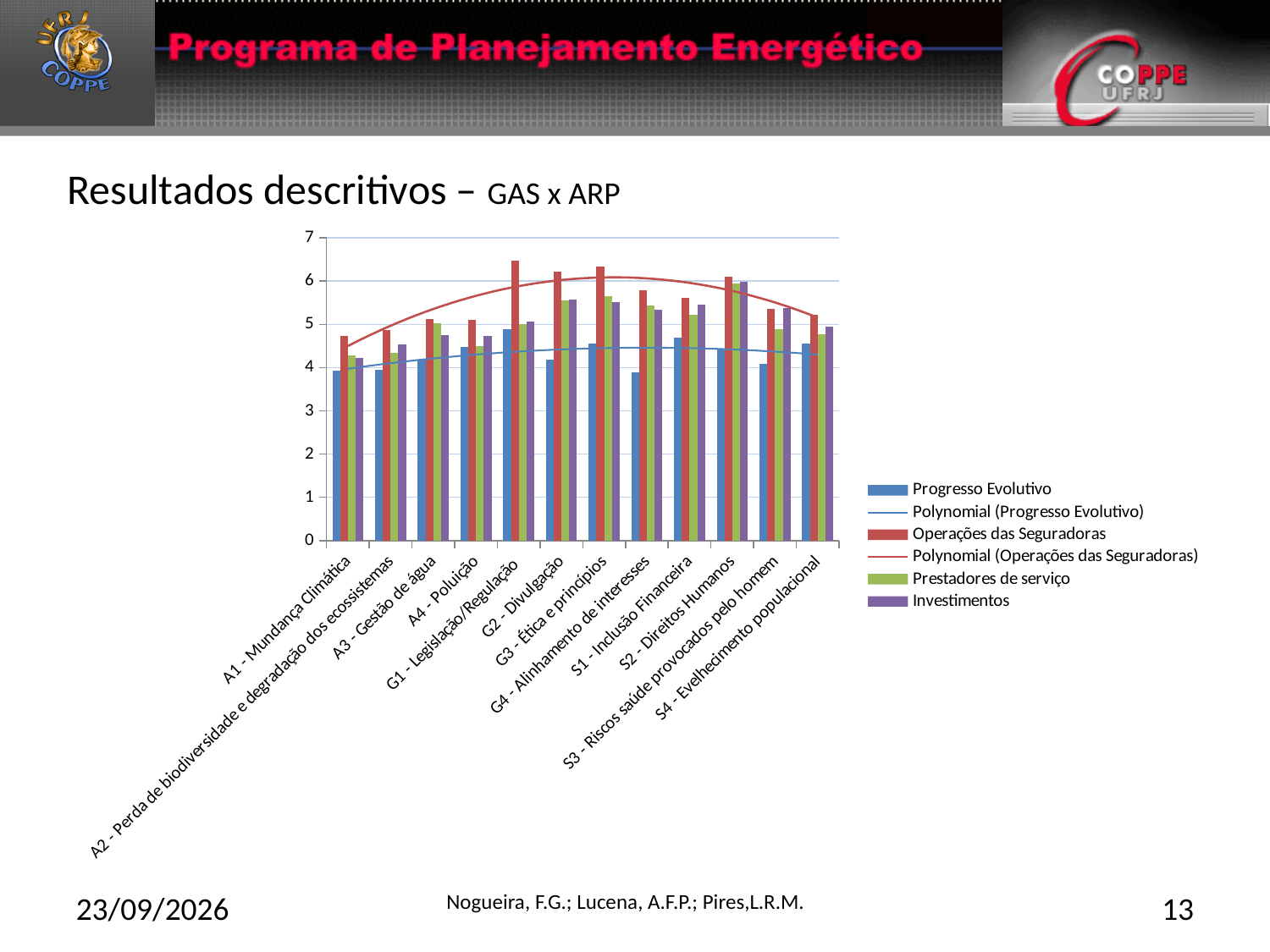
How many categories are shown along the x axis of the chart? 12 At S2 - Direitos Humanos, which is larger: Progresso Evolutivo or Investimentos? Investimentos Is the value for Operações das Seguradoras at A1 - Mundança Climática greater or less than 5? less What kind of chart is shown on the slide? Bar chart For which category is the Operações das Seguradoras bar the highest? G1 - Legislação/Regulação Is the value for Operações das Seguradoras at G1 - Legislação/Regulação greater or less than 6? greater What is the title of the slide containing the chart? Resultados descritivos – GAS x ARP At G1 - Legislação/Regulação, which is larger: Progresso Evolutivo or Operações das Seguradoras? Operações das Seguradoras Which colour represents the Investimentos series in the chart? Purple How many entries does the chart's legend list? 6 Is the value for Prestadores de serviço at G3 - Ética e princípios greater or less than 5? greater